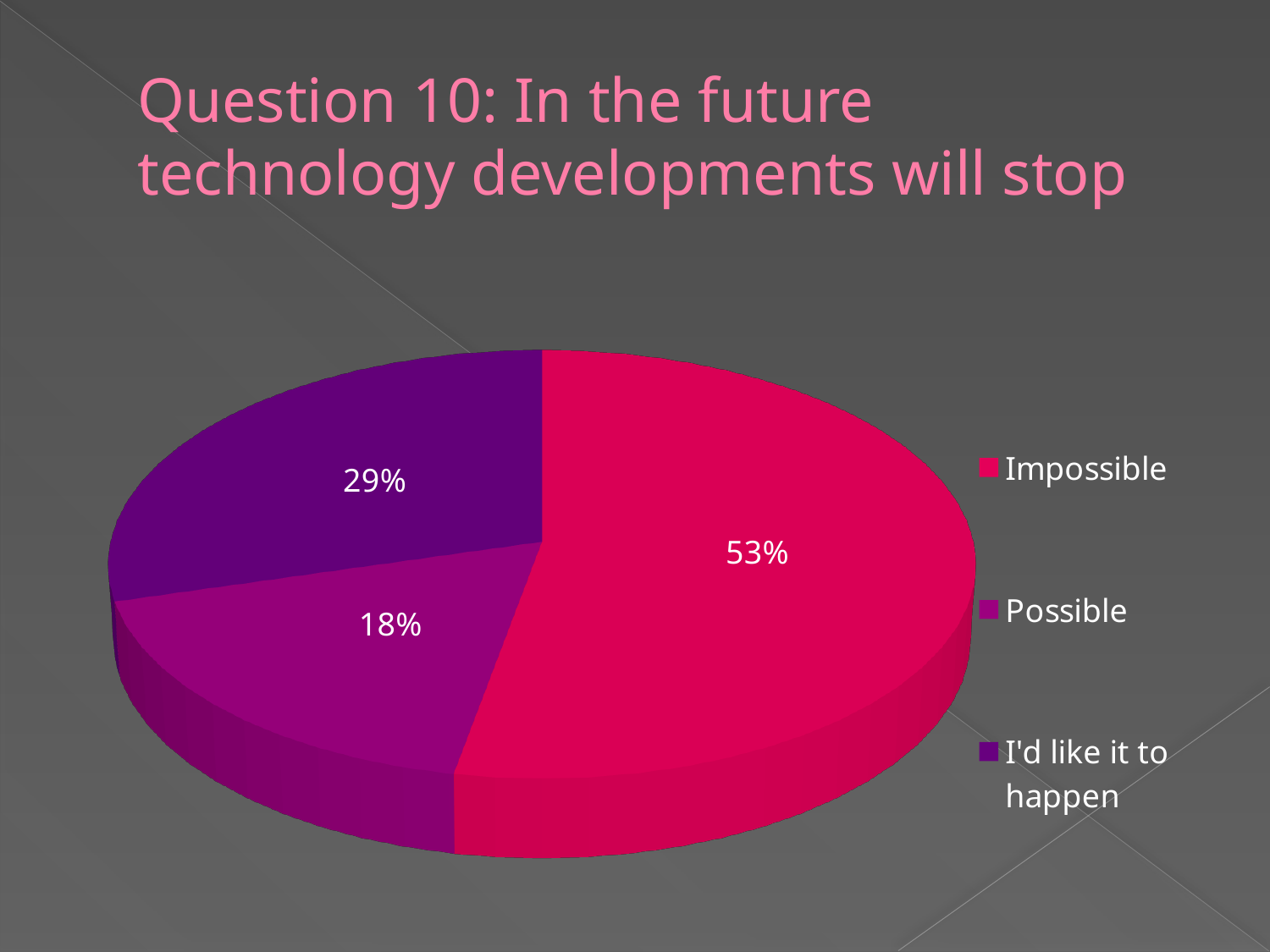
How many entries does the legend list? 3 What is the difference in percentage points between "I'd like it to happen" and "Possible"? 11 Which response has the smallest share of the pie? Possible Which response has the largest share of the pie? Impossible What percentage of respondents answered "Possible"? 18% What is the title of the slide containing the chart? Question 10: In the future technology developments will stop What percentage of respondents answered "Impossible"? 53% Which is larger, the share for "Possible" or the share for "I'd like it to happen"? I'd like it to happen What is the difference in percentage points between "Impossible" and "Possible"? 35 What percentage of respondents answered "I'd like it to happen"? 29% How many slices does the pie chart have? 3 What kind of chart is shown on the slide? pie chart